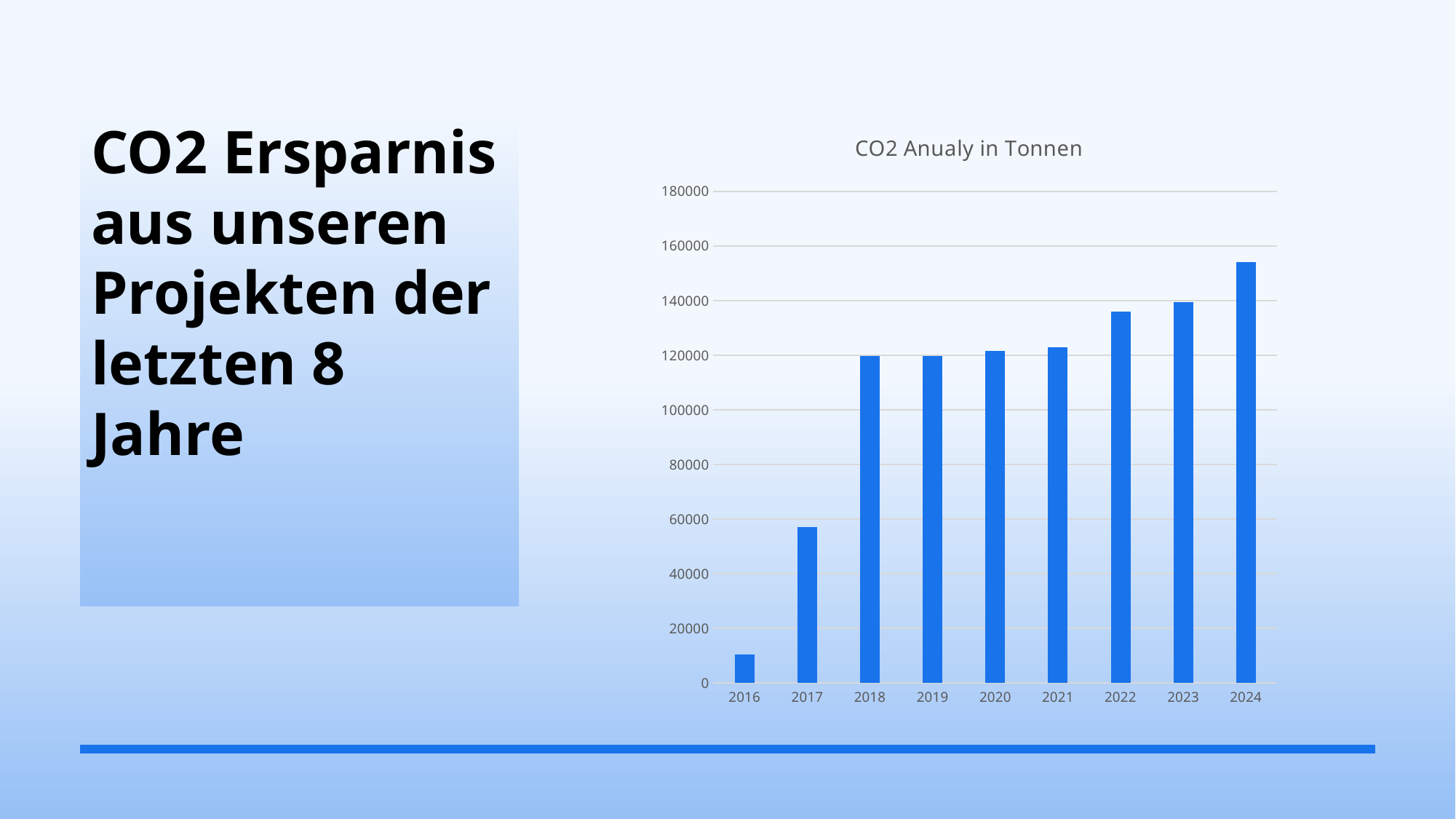
How many years are shown on the x axis of the chart? 9 Is the value for 2022 greater or less than 120000? greater Which is larger, the value for 2021 or the value for 2023? 2023 Which year has the lowest value in the chart? 2016 Is the value for 2017 greater or less than 60000? less Which year has the highest value in the chart? 2024 Is the value for 2016 greater or less than 20000? less Do the values generally rise or fall from 2016 to 2024? rise What is the title of the chart? CO2 Anualy in Tonnen Which is larger, the value for 2017 or the value for 2018? 2018 What kind of chart is shown on the slide? bar chart